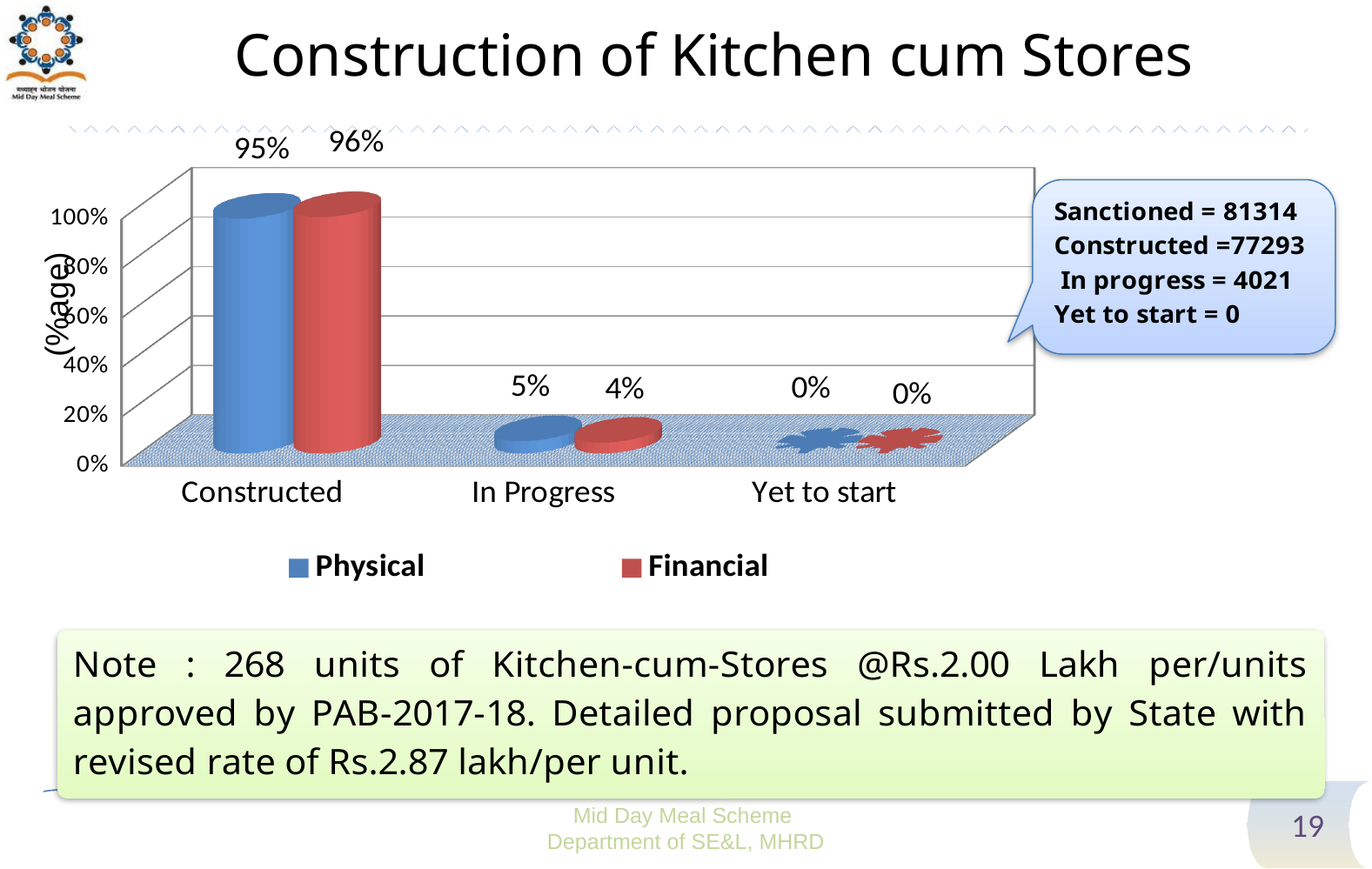
What is the difference between the Physical and Financial values for In Progress? 1% What is the Physical value for Constructed? 95% Which category has the lowest Financial value? Yet to start What kind of chart is shown on the slide? Bar chart Which is larger for Constructed, the Physical value or the Financial value? Financial What is the Physical value for Yet to start? 0% Which category has the highest Physical value? Constructed What is the Physical value for In Progress? 5% How many categories are shown on the x axis? 3 What is the Financial value for Constructed? 96% How many series does the legend list? 2 What is the Financial value for In Progress? 4%